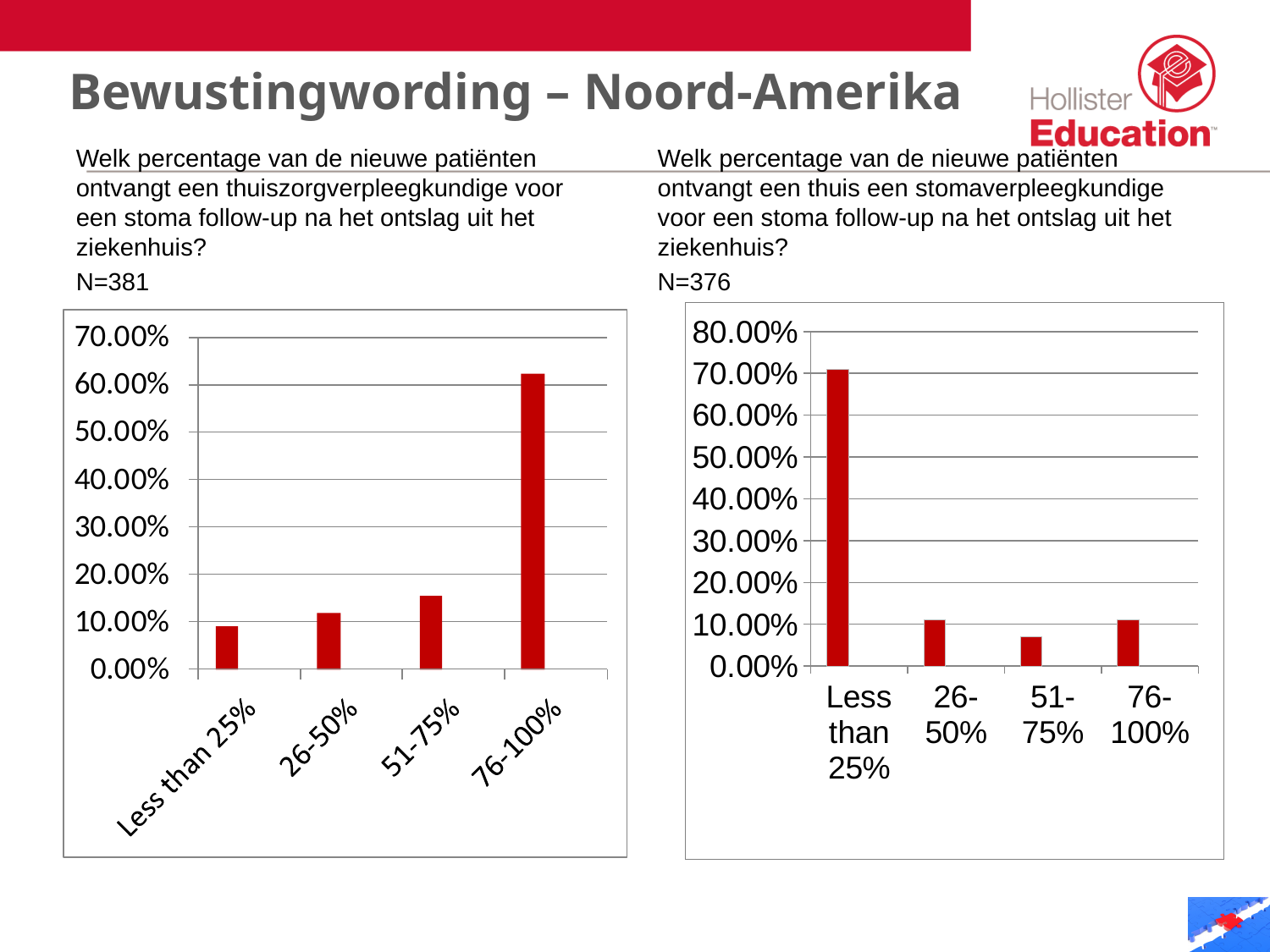
In the right chart (N=376), is the value for 51-75% greater or less than 10.00%? less In the left chart (N=381), which is larger, the value for 51-75% or the value for 76-100%? 76-100% In the left chart (N=381), which category has the highest value? 76-100% In the right chart (N=376), is the value for Less than 25% greater or less than 60.00%? greater What is the highest value shown on the y axis of the right chart (N=376)? 80.00% In the right chart (N=376), which category has the lowest value? 51-75% In the left chart (N=381), is the value for 26-50% greater or less than 20.00%? less In the right chart (N=376), which is larger, the value for Less than 25% or the value for 26-50%? Less than 25% What kind of chart is the right chart (N=376)? bar chart In the right chart (N=376), which category has the highest value? Less than 25% How many categories are shown on the x axis of the left chart (N=381)? 4